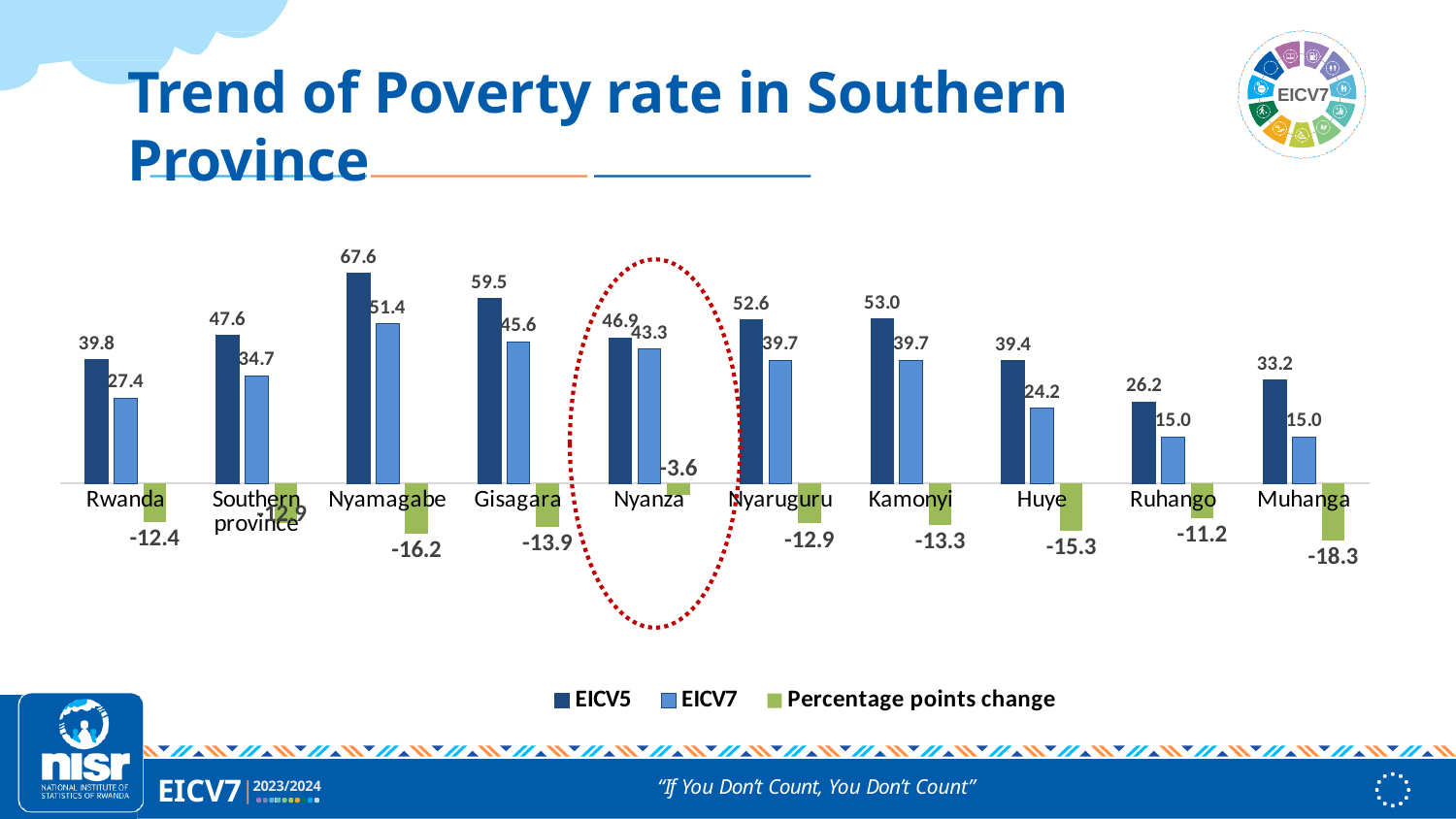
What is the title of the chart on the slide? Trend of Poverty rate in Southern Province Which is larger, the EICV7 poverty rate for Nyanza or for Nyaruguru? Nyanza Which district has the highest EICV5 poverty rate? Nyamagabe How many categories are shown on the x axis of the chart? 10 What is the difference between the EICV5 and EICV7 poverty rates for Gisagara? 13.9 What kind of chart is shown on the slide? Bar chart What is the percentage points change shown for Nyanza? -3.6 How many series does the legend list? 3 Which category has the lowest EICV5 poverty rate? Ruhango What is the EICV7 poverty rate for Huye? 24.2 What is the EICV5 poverty rate for Nyamagabe? 67.6 Which category shows the largest negative percentage points change? Muhanga